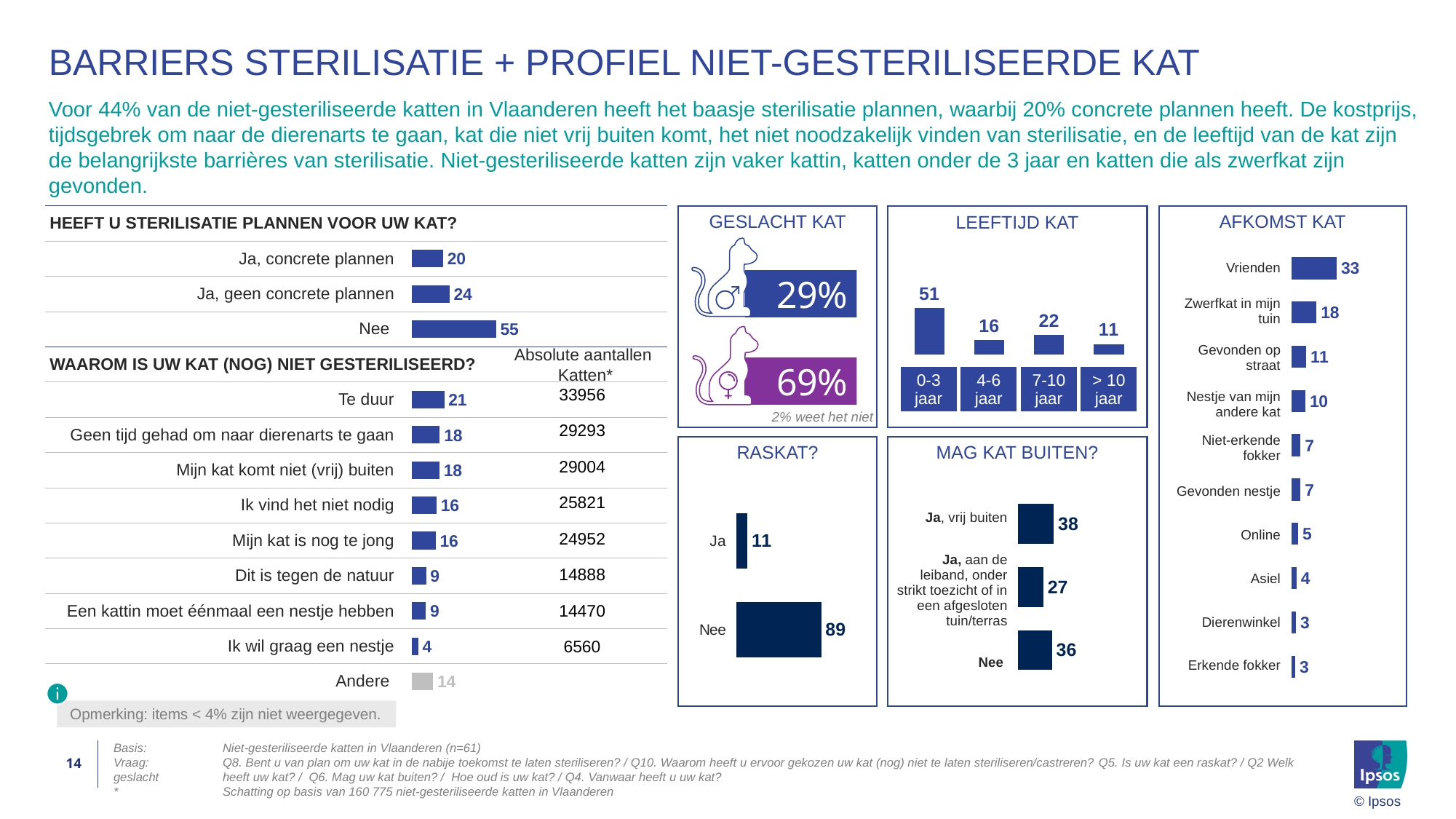
In the 'AFKOMST KAT' chart, what is the value for 'Zwerfkat in mijn tuin'? 18 In the 'HEEFT U STERILISATIE PLANNEN VOOR UW KAT?' chart, what is the difference between 'Ja, geen concrete plannen' and 'Ja, concrete plannen'? 4 In the 'LEEFTIJD KAT' chart, which age group has the highest value? 0-3 jaar In the 'MAG KAT BUITEN?' chart, which is larger: 'Ja, vrij buiten' or 'Nee'? Ja, vrij buiten What type of chart is the 'AFKOMST KAT' chart? Bar chart In the 'WAAROM IS UW KAT (NOG) NIET GESTERILISEERD?' chart, which reason has the highest value? Te duur In the 'GESLACHT KAT' chart, what percentage of cats are female? 69% In the 'HEEFT U STERILISATIE PLANNEN VOOR UW KAT?' chart, what is the value for 'Nee'? 55 In the 'LEEFTIJD KAT' chart, what is the value for '7-10 jaar'? 22 In the 'RASKAT?' chart, what is the difference between 'Nee' and 'Ja'? 78 In the 'WAAROM IS UW KAT (NOG) NIET GESTERILISEERD?' chart, how many reasons (bars) are shown? 9 In the 'WAAROM IS UW KAT (NOG) NIET GESTERILISEERD?' chart, what is the absolute number of cats for 'Mijn kat is nog te jong'? 24952